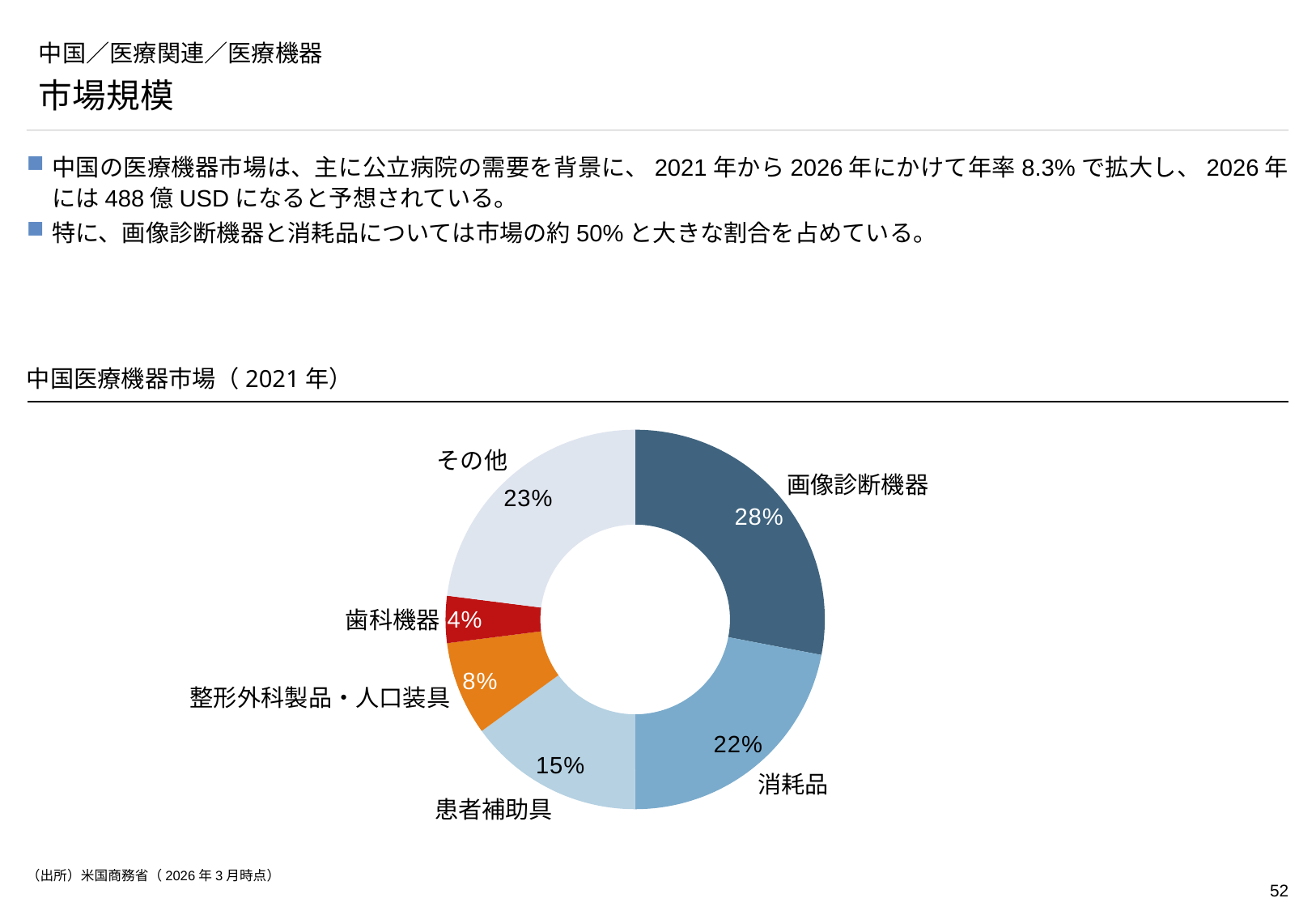
What share of the chart does 患者補助具 hold? 15% What share of the chart does 消耗品 hold? 22% How many categories are shown in the chart? 6 Which category has the largest share of the chart? 画像診断機器 What share of the chart does その他 hold? 23% What share of the chart does 歯科機器 hold? 4% What is the difference in percentage points between 画像診断機器 and 消耗品? 6 What share of the chart does 画像診断機器 hold? 28% What kind of chart is shown on the slide? Doughnut (pie) chart Which has a larger share, その他 or 消耗品? その他 What share of the chart does 整形外科製品・人口装具 hold? 8% Which category has the smallest share of the chart? 歯科機器